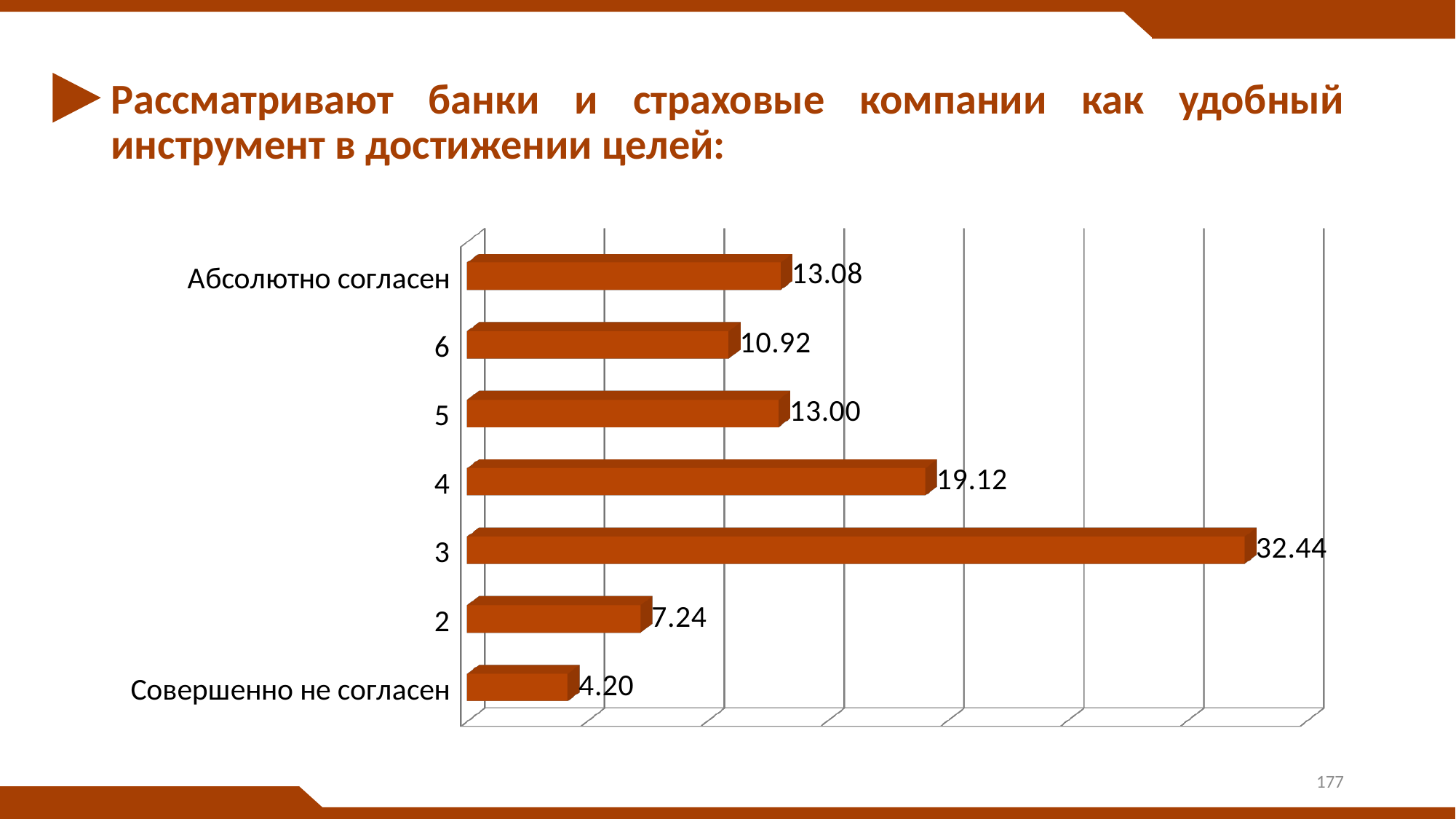
What is the value for "Абсолютно согласен"? 13.08 What is the difference between the values for category "2" and "Совершенно не согласен"? 3.04 Which is larger, the value for category "4" or the value for category "5"? 4 How many categories are shown in the chart? 7 Which category has the lowest value? Совершенно не согласен Which category has the highest value? 3 What is the difference between the values for category "3" and category "4"? 13.32 What colour are the bars in the chart? Orange-brown What kind of chart is shown on the slide? Bar chart What is the value for the category "3"? 32.44 What is the value for the category "6"? 10.92 What is the value for "Совершенно не согласен"? 4.20